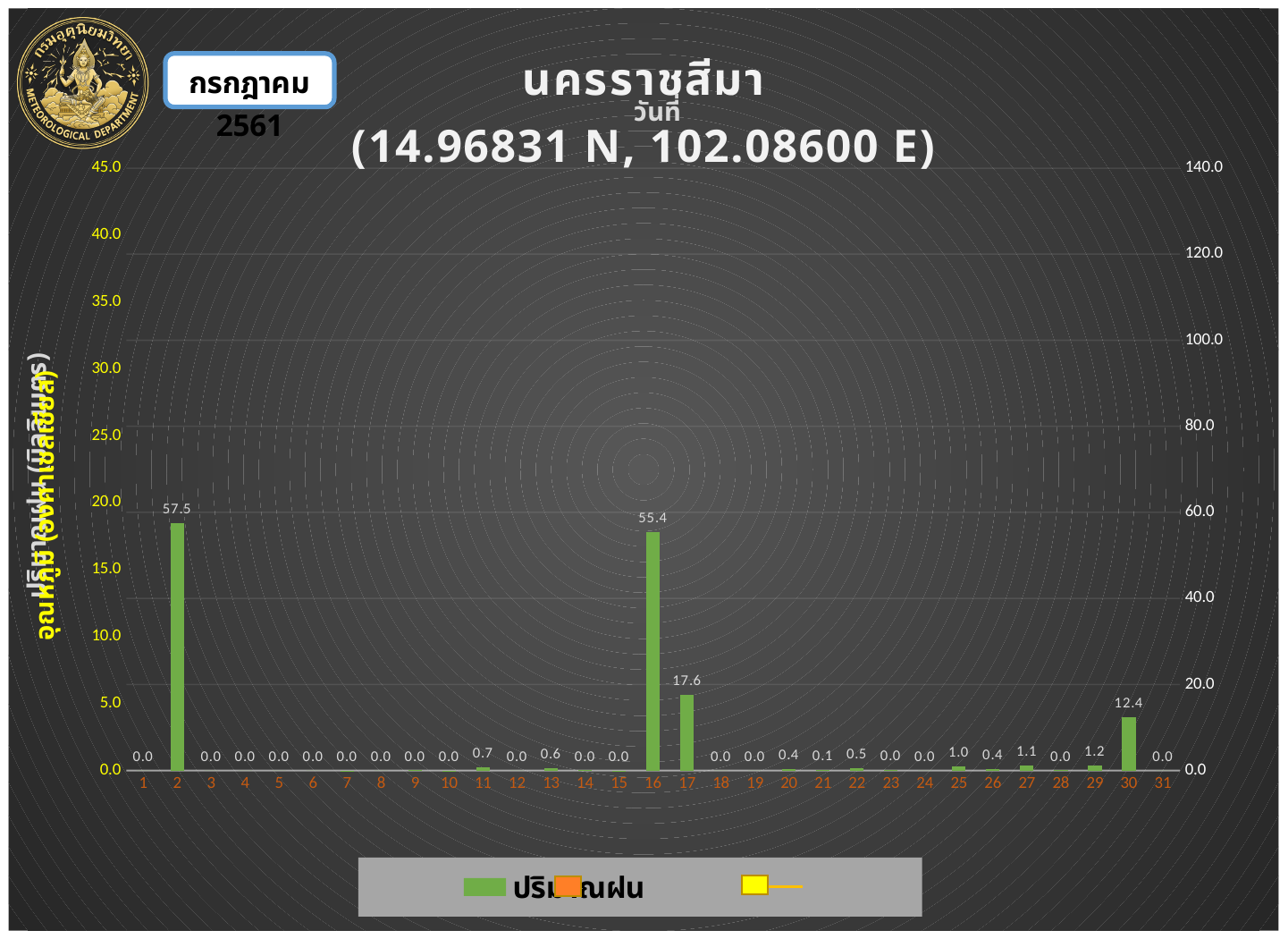
What is the rainfall value shown for day 2? 57.5 Which has the larger rainfall value, day 17 or day 30? day 17 What is the rainfall value shown for day 27? 1.1 What kind of chart is shown on the slide? bar chart What is the rainfall value shown for day 17? 17.6 What are the coordinates shown in the chart title? 14.96831 N, 102.08600 E What is the difference between the rainfall values for day 2 and day 16? 2.1 What is the rainfall value shown for day 30? 12.4 What is the difference between the rainfall values for day 17 and day 30? 5.2 How many days are shown on the x axis? 31 What is the rainfall value shown for day 16? 55.4 Which day has the highest rainfall value? 2